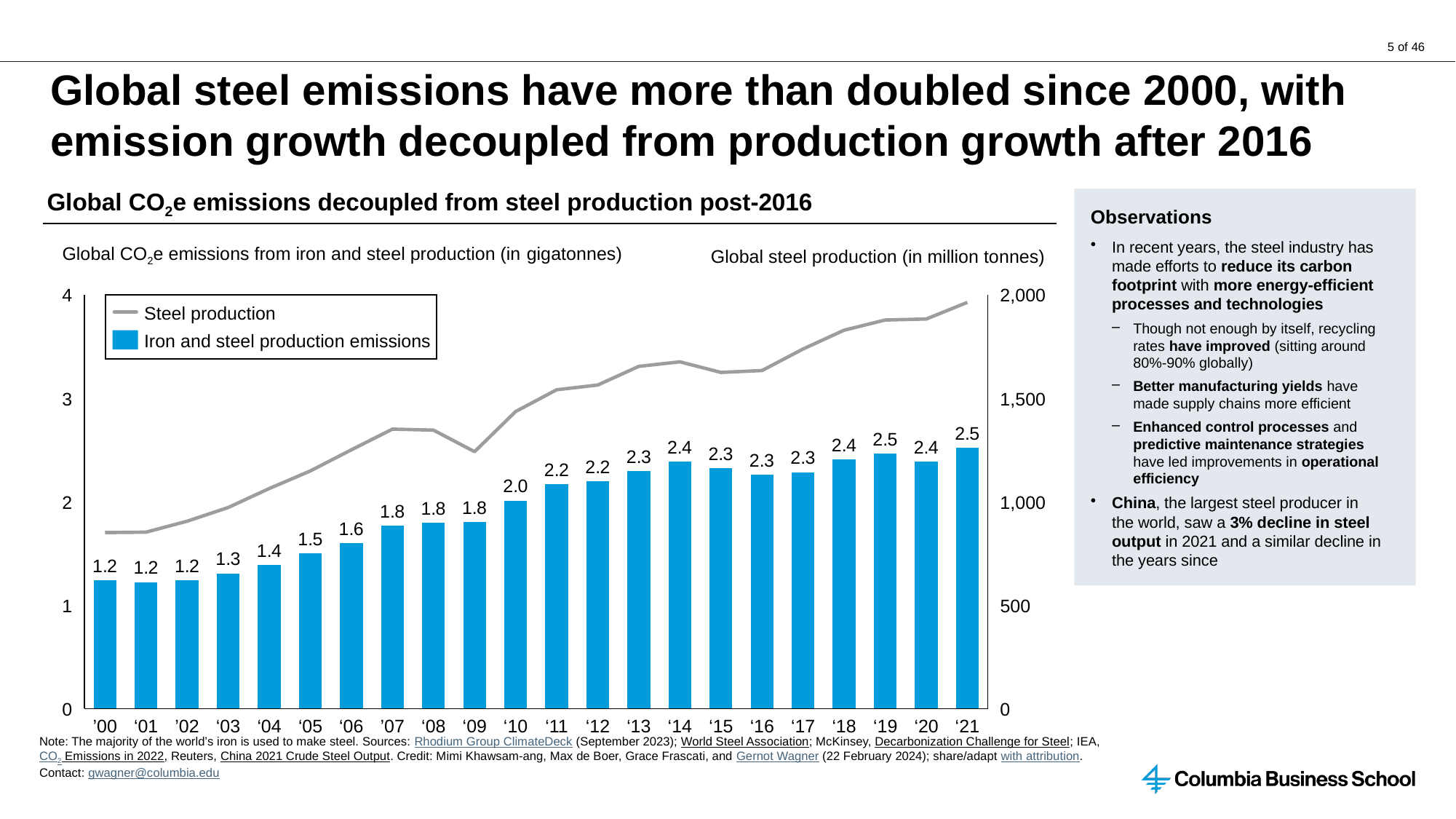
What is the value of iron and steel production emissions for '05? 1.5 What is the lowest labelled value of iron and steel production emissions shown on the chart? 1.2 Do iron and steel production emissions generally rise or fall from '00 to '21? rise What is the highest labelled value of iron and steel production emissions shown on the chart? 2.5 Which year has higher iron and steel production emissions, '14 or '15? '14 Is the steel production value for '21 greater or less than 1,500? greater What is the difference between iron and steel production emissions in '21 and in '00? 1.3 How many years are shown on the x axis of the chart? 22 What is the value of iron and steel production emissions for '10? 2.0 What is the value of iron and steel production emissions for '21? 2.5 How many series does the legend list? 2 Is the steel production value for '00 greater or less than 1,000? less